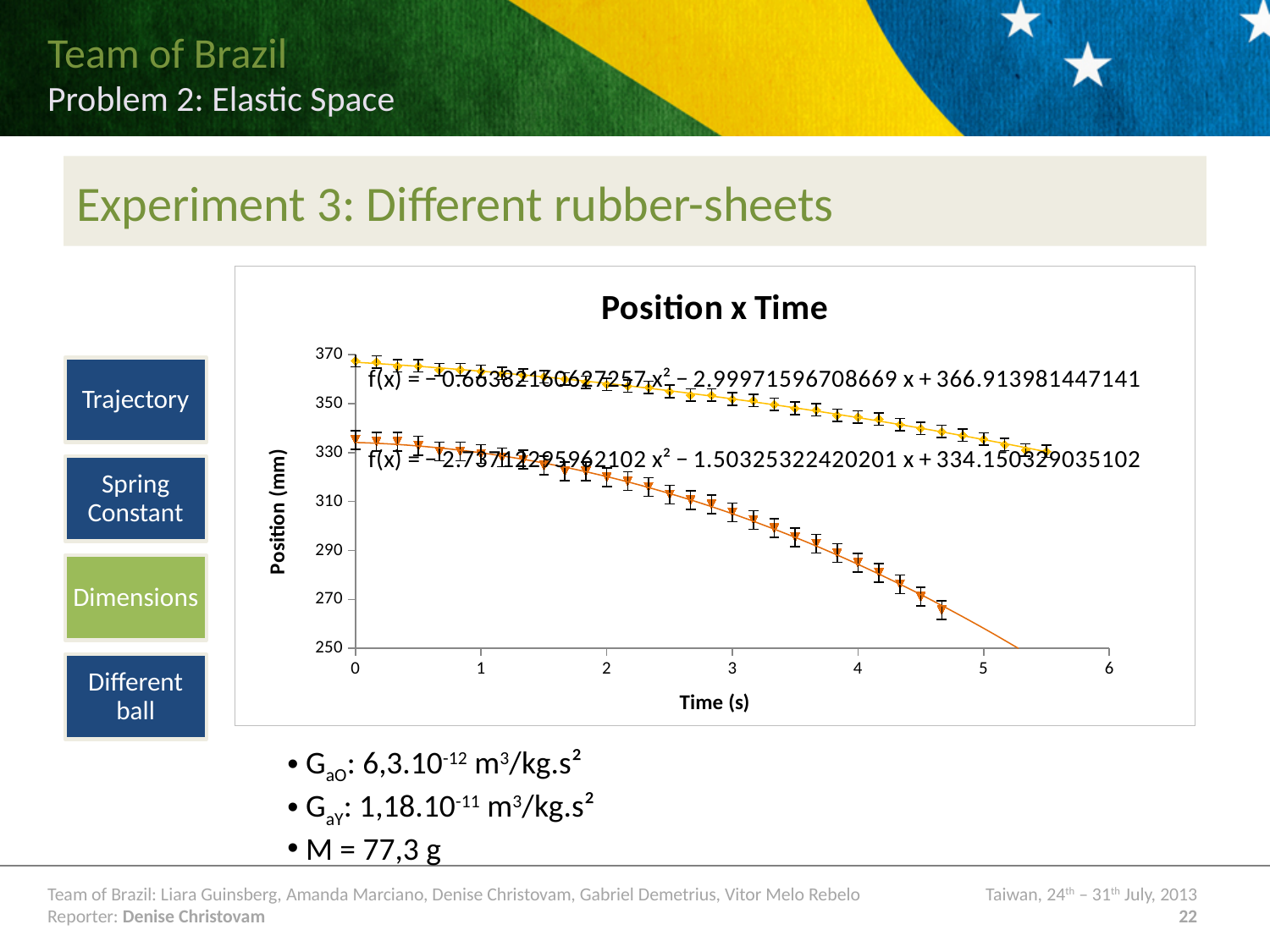
What is the title of the chart? Position x Time What kind of chart is shown on the slide? scatter chart What is the constant term in the trendline equation for the lower series? 334.150329035102 At time 2 s, which series has the higher position, the upper (yellow) series or the lower (orange) series? the upper (yellow) series What is the constant term in the trendline equation for the upper series? 366.913981447141 Do the plotted positions rise or fall as time increases? fall What is the highest value shown on the vertical axis of the chart? 370 How many data series are plotted in the chart? 2 What is the label of the vertical axis of the chart? Position (mm) Is the position of the lower (orange) series at time 2 s greater or less than 310? greater Is the position of the lower (orange) series at time 4 s greater or less than 310? less Is the position of the upper (yellow) series at time 1 s greater or less than 350? greater